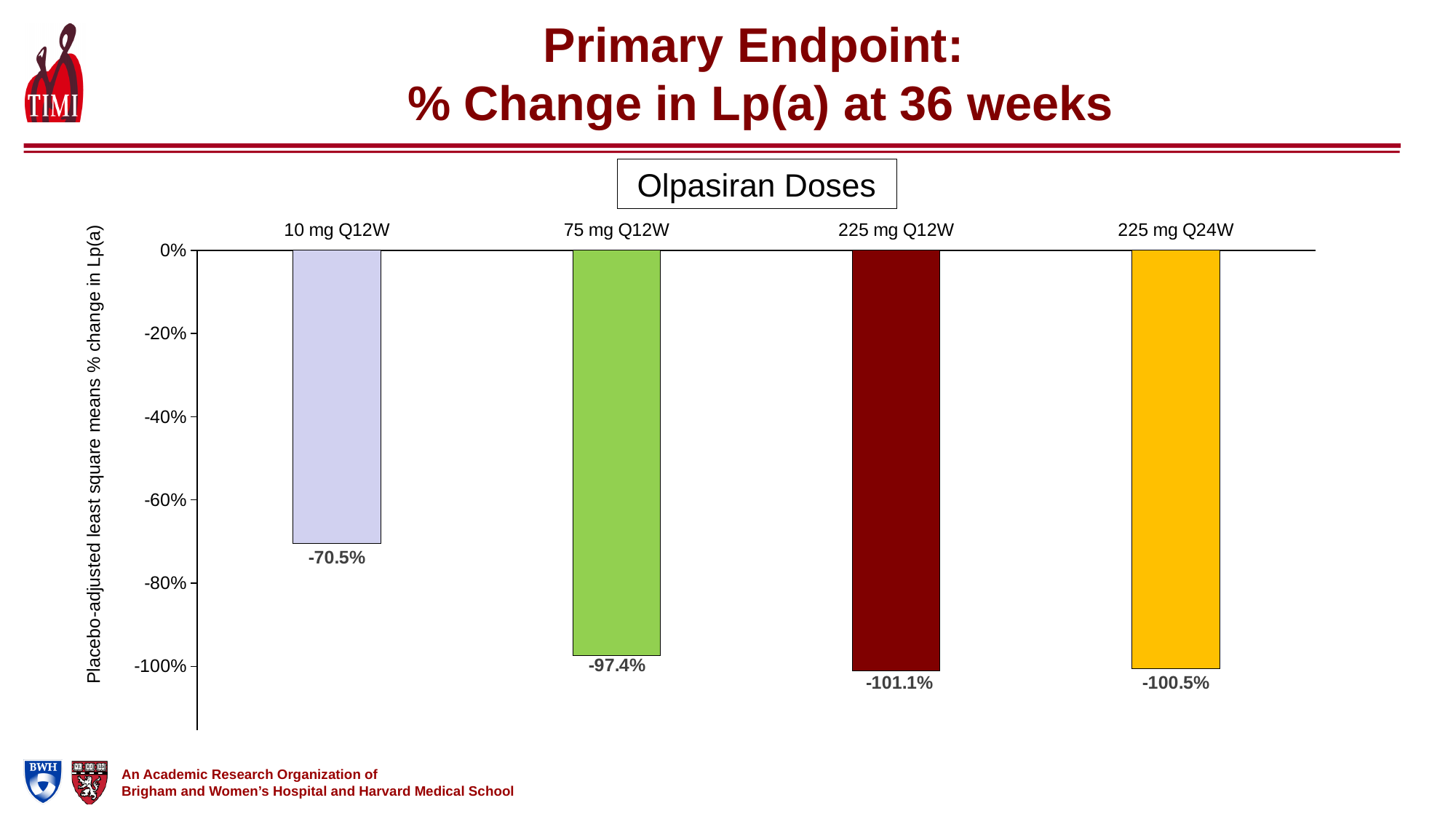
What colour is the bar for the 225 mg Q12W dose? Dark red How many olpasiran doses are shown in the chart? 4 What is the label of the y axis? Placebo-adjusted least square means % change in Lp(a) Which dose shows the smallest reduction in Lp(a)? 10 mg Q12W What is the placebo-adjusted % change in Lp(a) for the 10 mg Q12W dose? -70.5% Which dose shows the largest reduction in Lp(a)? 225 mg Q12W What is the difference between the % change for 75 mg Q12W and 10 mg Q12W? 26.9 percentage points What is the placebo-adjusted % change in Lp(a) for the 75 mg Q12W dose? -97.4% What type of chart is shown on the slide? Bar chart What is the placebo-adjusted % change in Lp(a) for the 225 mg Q12W dose? -101.1% What is the placebo-adjusted % change in Lp(a) for the 225 mg Q24W dose? -100.5% Which dose has a larger reduction in Lp(a): 10 mg Q12W or 75 mg Q12W? 75 mg Q12W